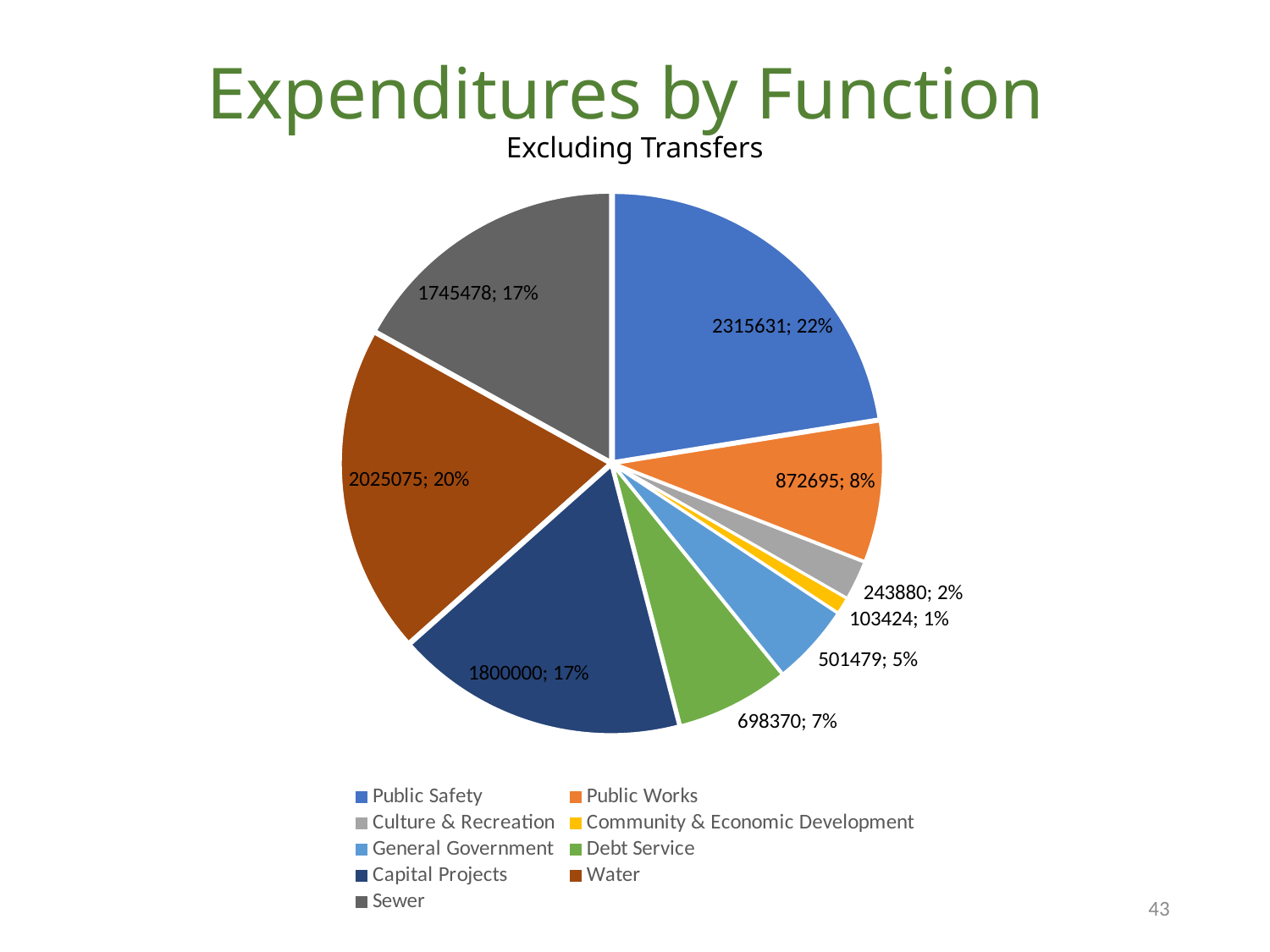
Which category has the largest slice? Public Safety What kind of chart is shown on the slide? pie chart What is the difference between the values for Water and Capital Projects? 225075 What share of the pie does Public Works represent? 8% What share of the pie does Sewer represent? 17% What is the value for Capital Projects? 1800000 Which is larger, Debt Service or General Government? Debt Service What is the value for Water? 2025075 How many categories does the legend list? 9 Which category has the smallest slice? Community & Economic Development What is the value for Community & Economic Development? 103424 What is the value for Public Safety? 2315631